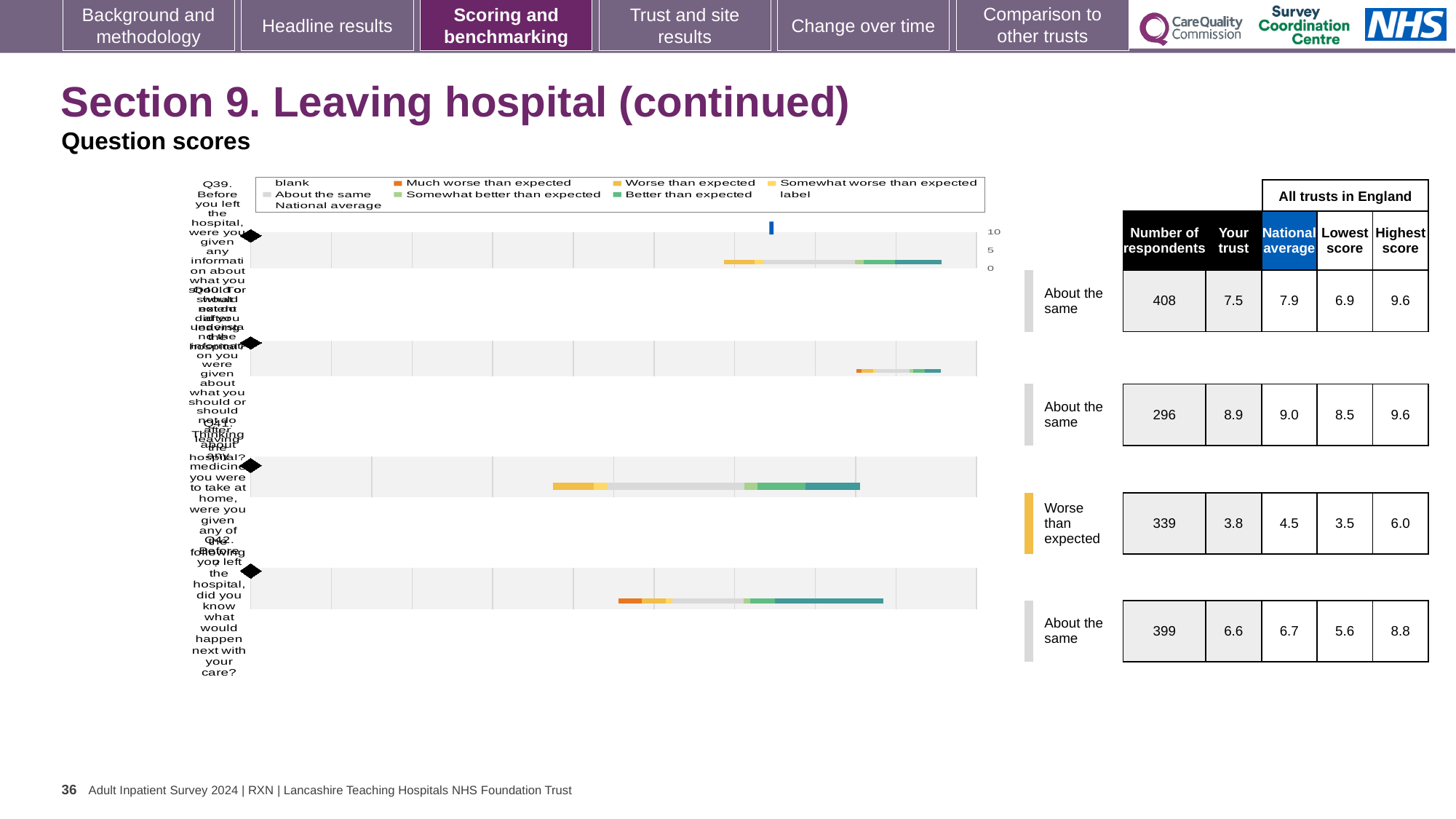
What is the difference between the national average and the trust score for Q39? 0.4 What is the highest score among all trusts in England for Q42? 8.8 How many of the four questions are rated 'About the same'? 3 For Q42, which is larger: the trust score or the national average? national average What is the national average score for Q39? 7.9 Which question has the lowest 'Your trust' score? Q41 What benchmark category is shown for Q41? Worse than expected Which question has the highest 'Your trust' score? Q40 How many questions (bars) are plotted in the chart? 4 What is the 'Your trust' score for Q41 (medicines to take at home)? 3.8 How many respondents answered Q40? 296 What kind of chart is shown on the slide? bar chart